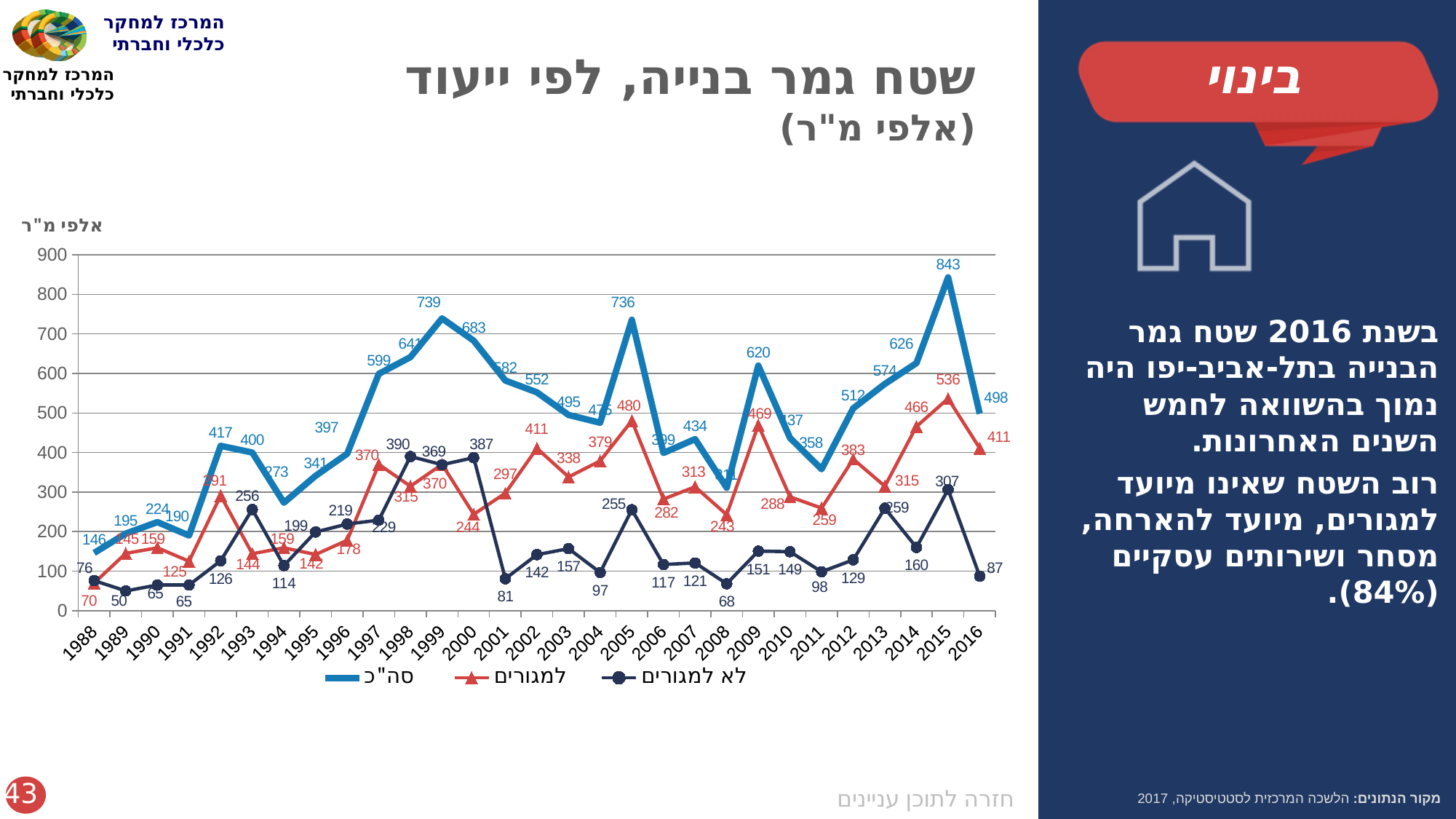
What is the difference between the למגורים and לא למגורים values in 2016? 324 What is the value of the סה"כ series in 2015? 843 What is the value of the למגורים series in 2016? 411 Is the סה"כ value for 2009 greater or less than 600? greater How many series does the legend list? 3 In which year is the לא למגורים series at its lowest value? 1989 In 2005, which is larger: the למגורים value or the לא למגורים value? למגורים What is the value of the לא למגורים series in 1998? 390 Does the סה"כ series rise or fall from 2013 to 2015? rise What kind of chart is shown on the slide? line chart In which year does the סה"כ series reach its highest value? 2015 How many years are shown on the x axis? 29